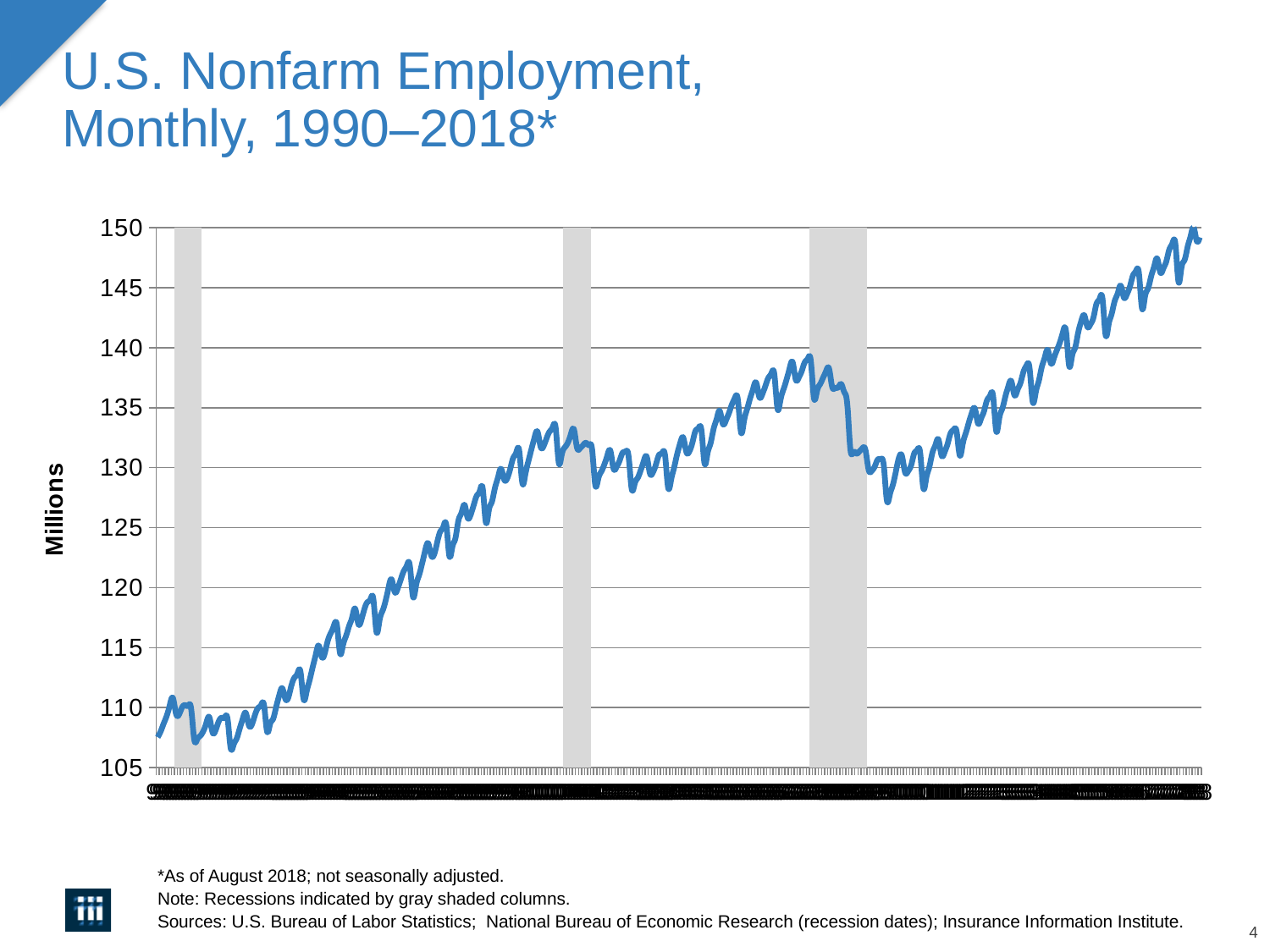
What is the highest value shown on the vertical axis? 150 Overall, does the line rise or fall from the left of the chart to the right? Rise Is the lowest point on the line greater or less than 110? less Is the value at the end of the series greater or less than 140? greater What is the label on the vertical axis of the chart? Millions What kind of chart is shown on the slide? Line chart What is the title of the chart on the slide? U.S. Nonfarm Employment, Monthly, 1990–2018* Is the value at the start of the series (far left of the chart) greater or less than 110? less Is the value at the end of the series greater or less than the value at the start of the series? greater